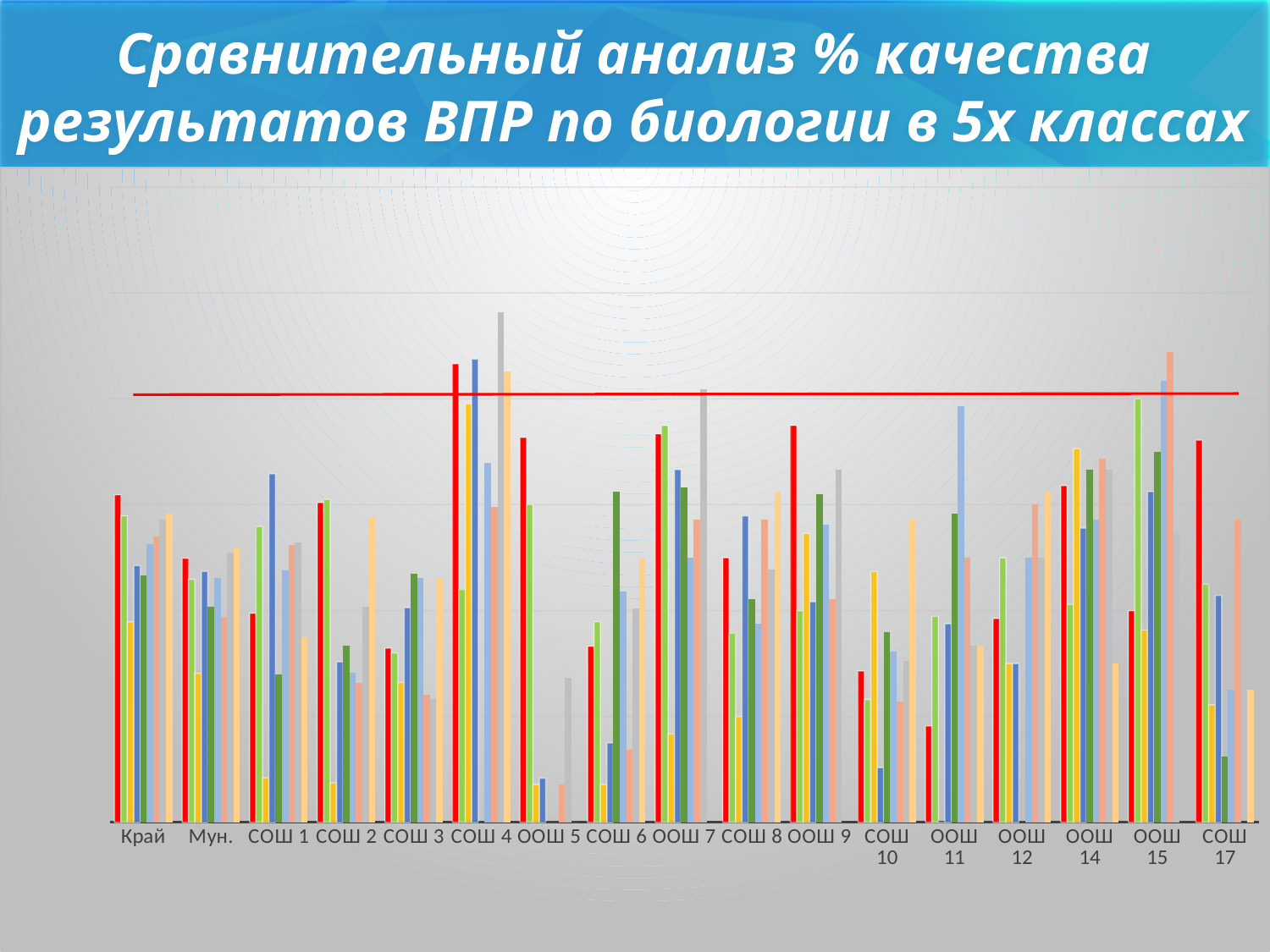
What is the first category label on the x axis? Край Which category contains the tallest bar of any colour in the chart? СОШ 4 Which category has the tallest red bar? СОШ 4 Of the red bars shown, which category has the shortest one? ООШ 11 Which has the taller red bar, СОШ 17 or ООШ 15? СОШ 17 How many categories are shown along the x axis of the chart? 17 Which has the taller red bar, СОШ 8 or ООШ 9? ООШ 9 Which has the taller red bar, СОШ 4 or СОШ 10? СОШ 4 What kind of chart is shown on the slide? bar chart What is the title of the slide's chart? Сравнительный анализ % качества результатов ВПР по биологии в 5х классах